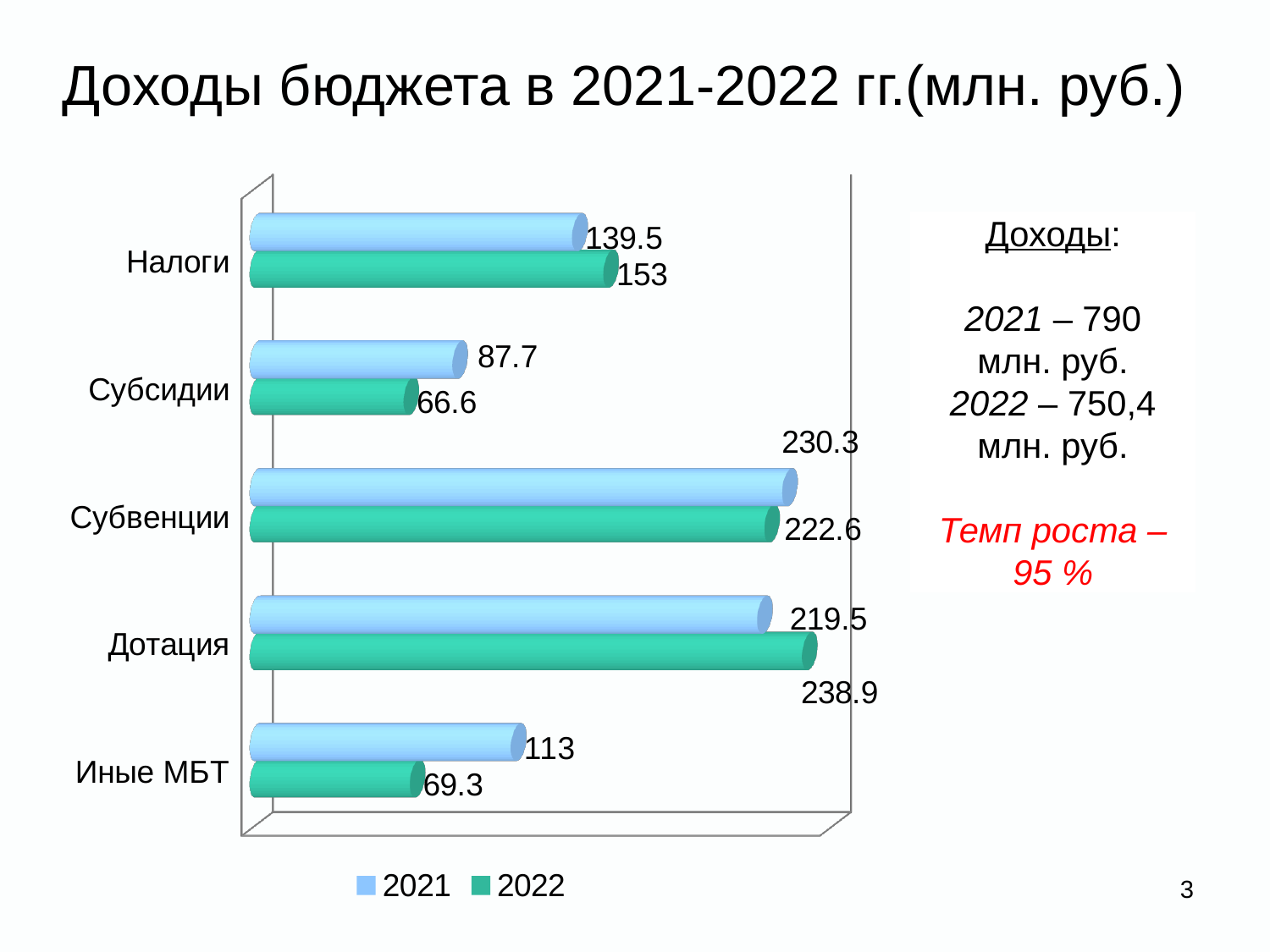
What kind of chart is shown on the slide? Bar chart What is the difference between the 2022 and 2021 values for Налоги? 13.5 Which category has the highest value in the 2021 series? Субвенции How many series does the legend list? 2 How many categories are shown on the chart? 5 What is the value for Иные МБТ in the 2022 series? 69.3 What is the difference between the 2021 and 2022 values for Иные МБТ? 43.7 What is the title of the chart on the slide? Доходы бюджета в 2021-2022 гг.(млн. руб.) Which category has the lowest value in the 2022 series? Субсидии Which is larger for Субсидии: the 2021 value or the 2022 value? 2021 What is the value for Налоги in the 2021 series? 139.5 What is the value for Дотация in the 2022 series? 238.9